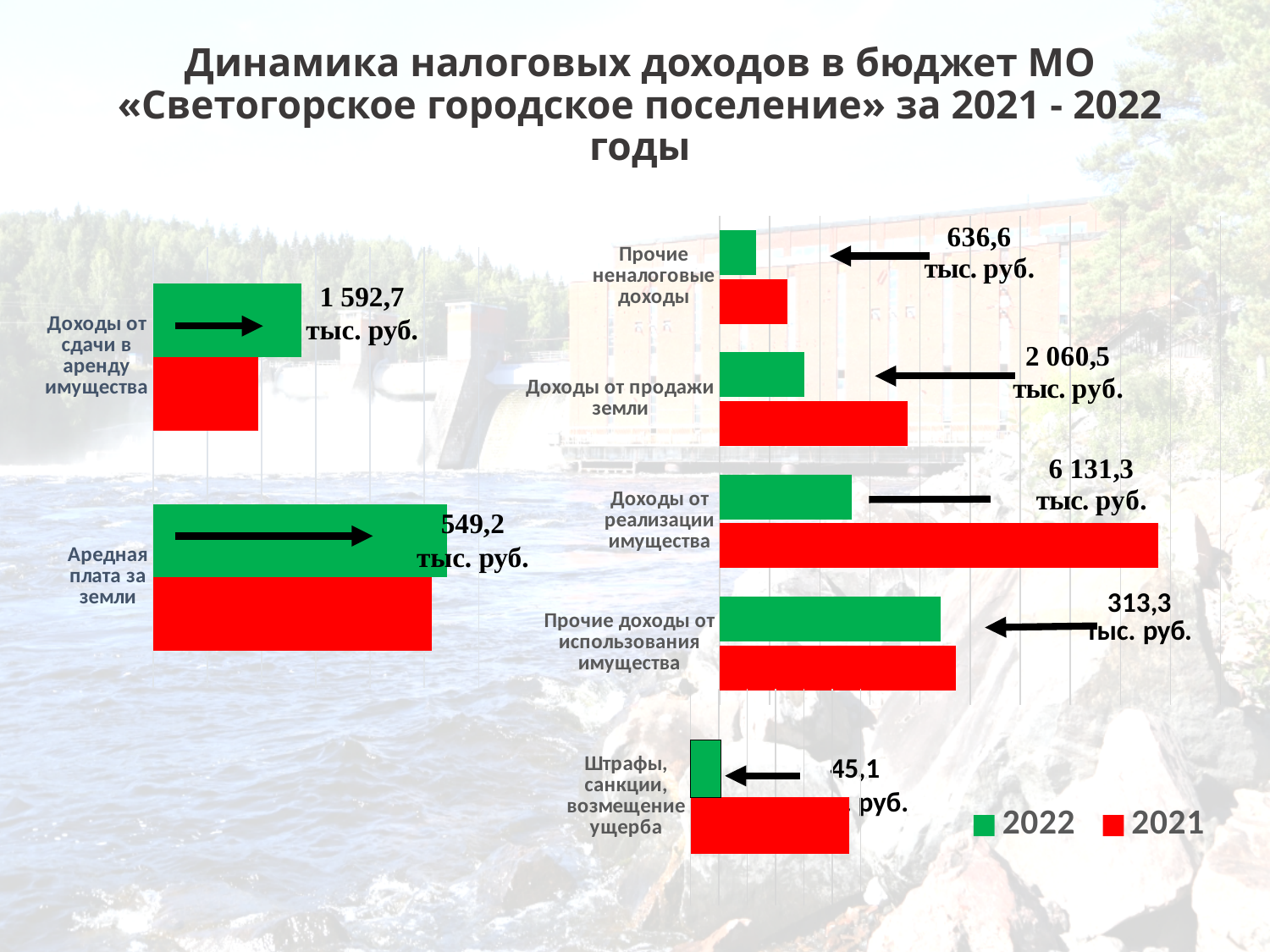
Which colour represents 2022 in the charts? green What kind of chart is used on the slide to show the income categories? bar chart In the right chart, for 'Прочие неналоговые доходы', which year has the larger bar, 2022 or 2021? 2021 In the right chart, for 'Доходы от реализации имущества', which year has the larger bar, 2022 or 2021? 2021 In the right chart, which category has the longest 2021 bar? Доходы от реализации имущества In the right chart, which category has the shortest 2022 bar? Прочие неналоговые доходы In the bottom chart, for 'Штрафы, санкции, возмещение ущерба', which year has the larger bar, 2022 or 2021? 2021 How many series does the legend list? 2 Which two years are listed in the legend? 2022 and 2021 How many categories are shown in the left chart? 2